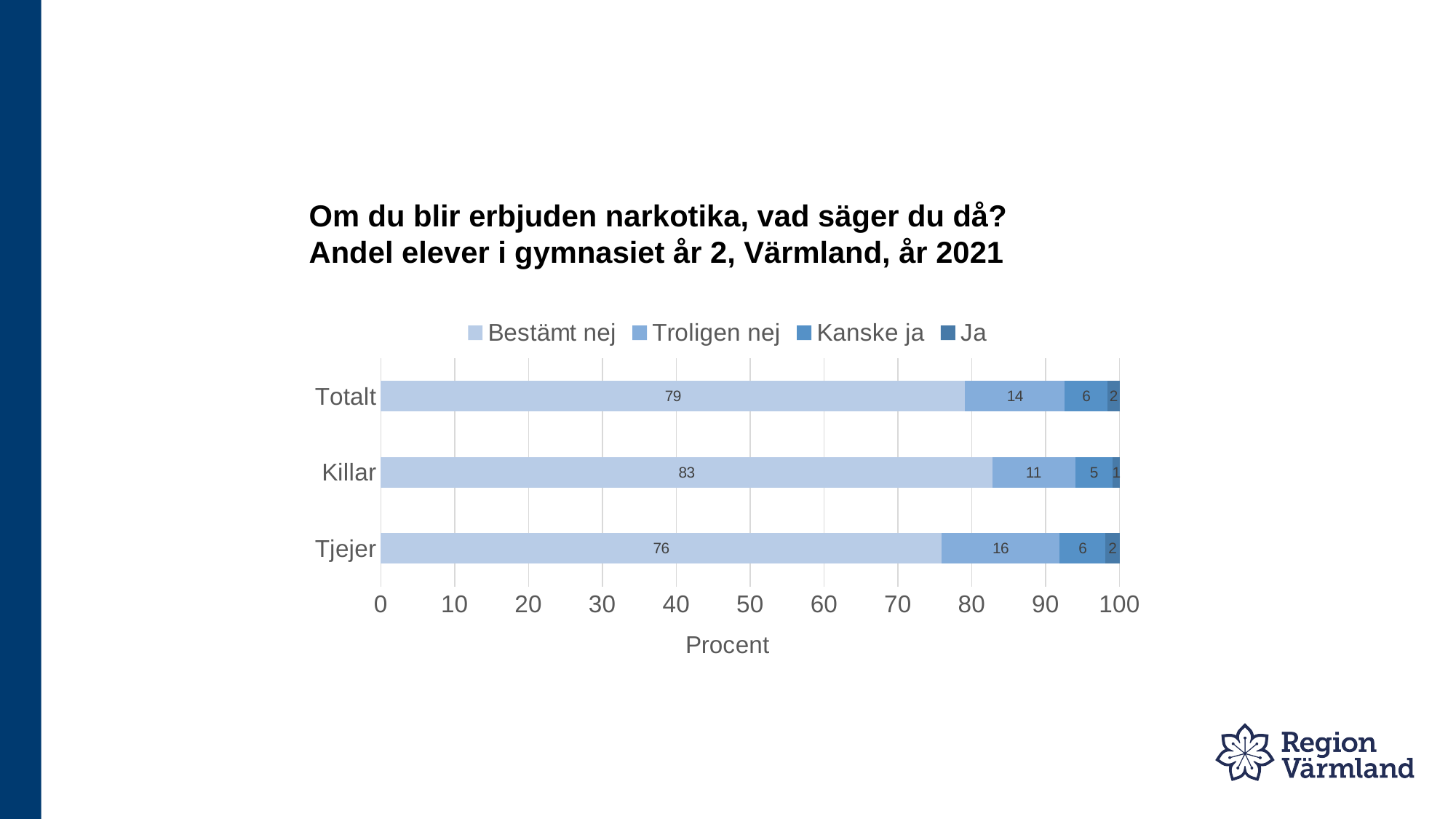
Which is larger: the "Troligen nej" value for Totalt or for Tjejer? Tjejer What is the difference between the "Bestämt nej" values for Killar and Tjejer? 7 What is the value of "Ja" for Killar? 1 What is the value of "Troligen nej" for Tjejer? 16 How many categories are shown on the y axis? 3 What is the value of "Kanske ja" for Totalt? 6 Which category has the highest value for "Bestämt nej"? Killar What is the total of the stacked bar for Tjejer? 100 How many series does the legend list? 4 What kind of chart is shown on the slide? Stacked bar chart What is the value of "Bestämt nej" for Killar? 83 Which category has the lowest value for "Troligen nej"? Killar